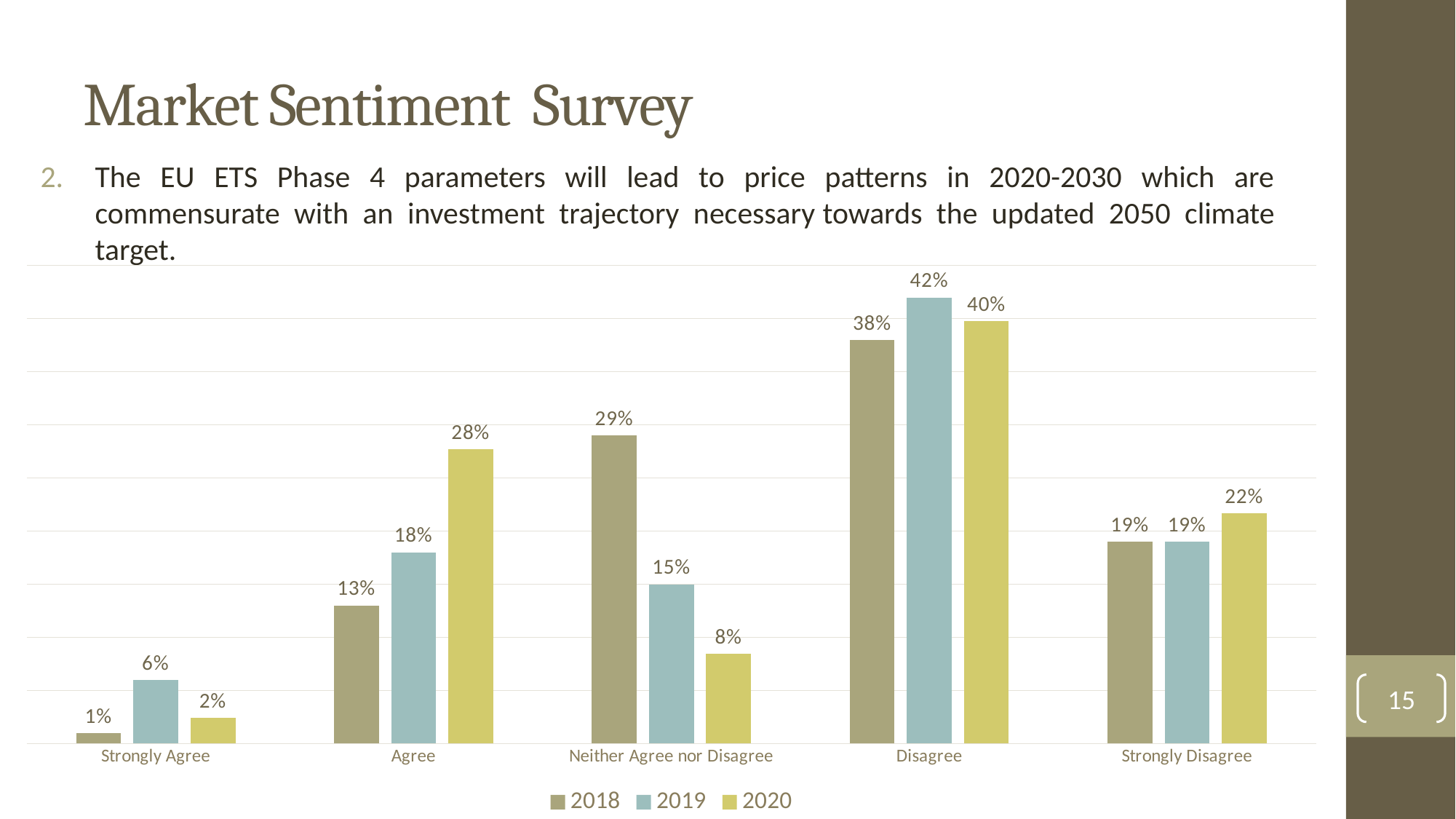
How many series does the legend list? 3 What is the value for 2018 in the Neither Agree nor Disagree category? 29% What is the value for 2020 in the Agree category? 28% Which is larger in the Strongly Disagree category: the 2020 value or the 2018 value? 2020 What kind of chart is shown on the slide? Bar chart Which category has the lowest value for the 2018 series? Strongly Agree What is the value for 2019 in the Strongly Agree category? 6% What is the difference between the 2019 and 2020 values in the Disagree category? 2% How many categories are shown on the x axis? 5 Which category has the highest value for the 2019 series? Disagree What is the difference between the 2018 and 2020 values in the Neither Agree nor Disagree category? 21% Which series is shown in yellow in the legend? 2020